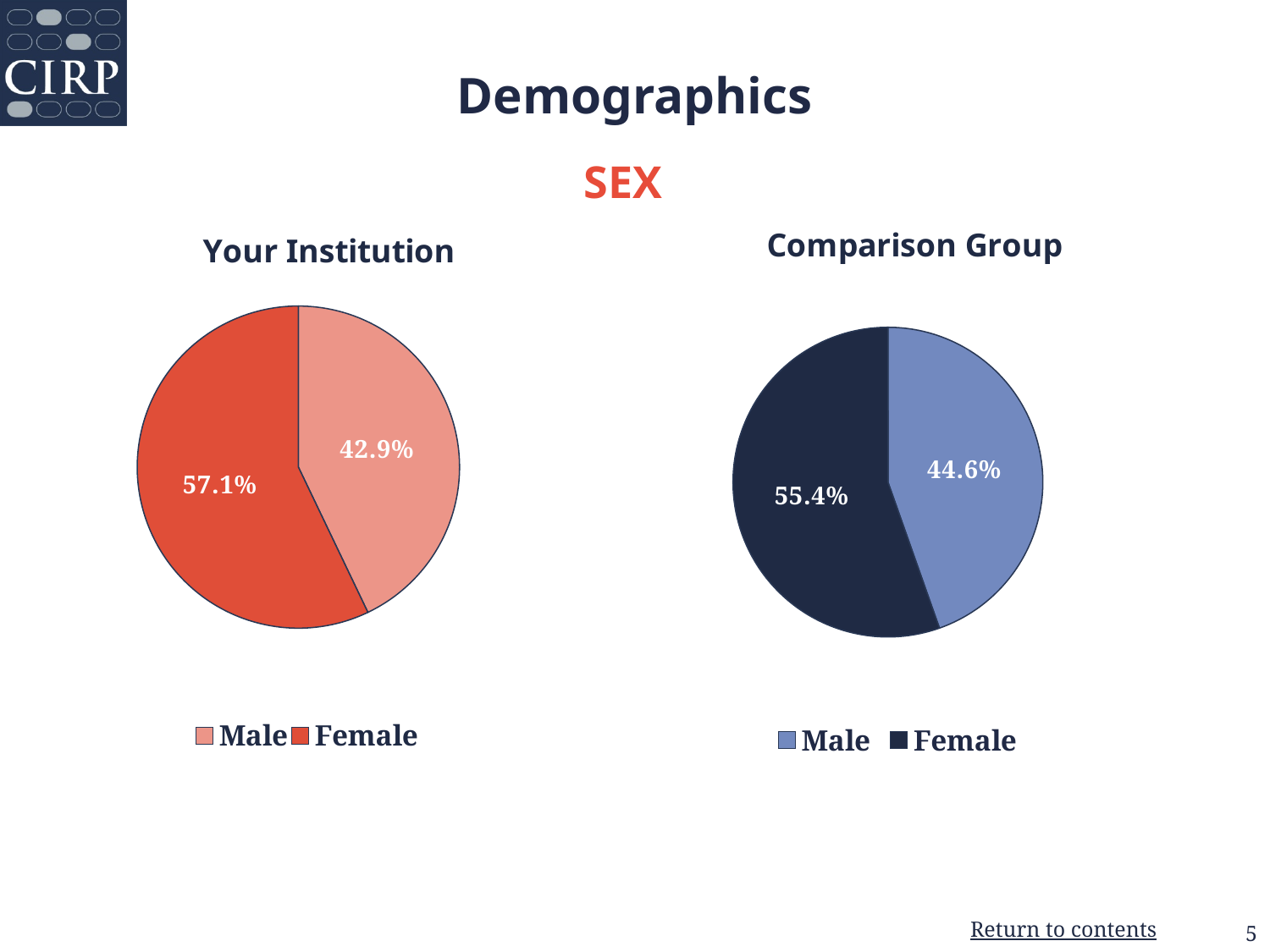
In the 'Your Institution' pie chart, what is the difference in percentage points between Female and Male? 14.2 In the 'Your Institution' pie chart, what percentage is Female? 57.1% In the 'Comparison Group' pie chart, what percentage is Female? 55.4% In the 'Comparison Group' pie chart, what is the difference in percentage points between Female and Male? 10.8 In the 'Your Institution' pie chart, which category has the largest share? Female What type of chart is used for 'Your Institution'? Pie chart In the 'Comparison Group' pie chart, what colour is the Female slice? Dark navy blue In the 'Comparison Group' pie chart, which category has the smallest share? Male Is the Male share larger in the 'Your Institution' chart or the 'Comparison Group' chart? Comparison Group How many categories does the 'Comparison Group' pie chart show? 2 In the 'Your Institution' pie chart, what percentage is Male? 42.9% In the 'Comparison Group' pie chart, what percentage is Male? 44.6%